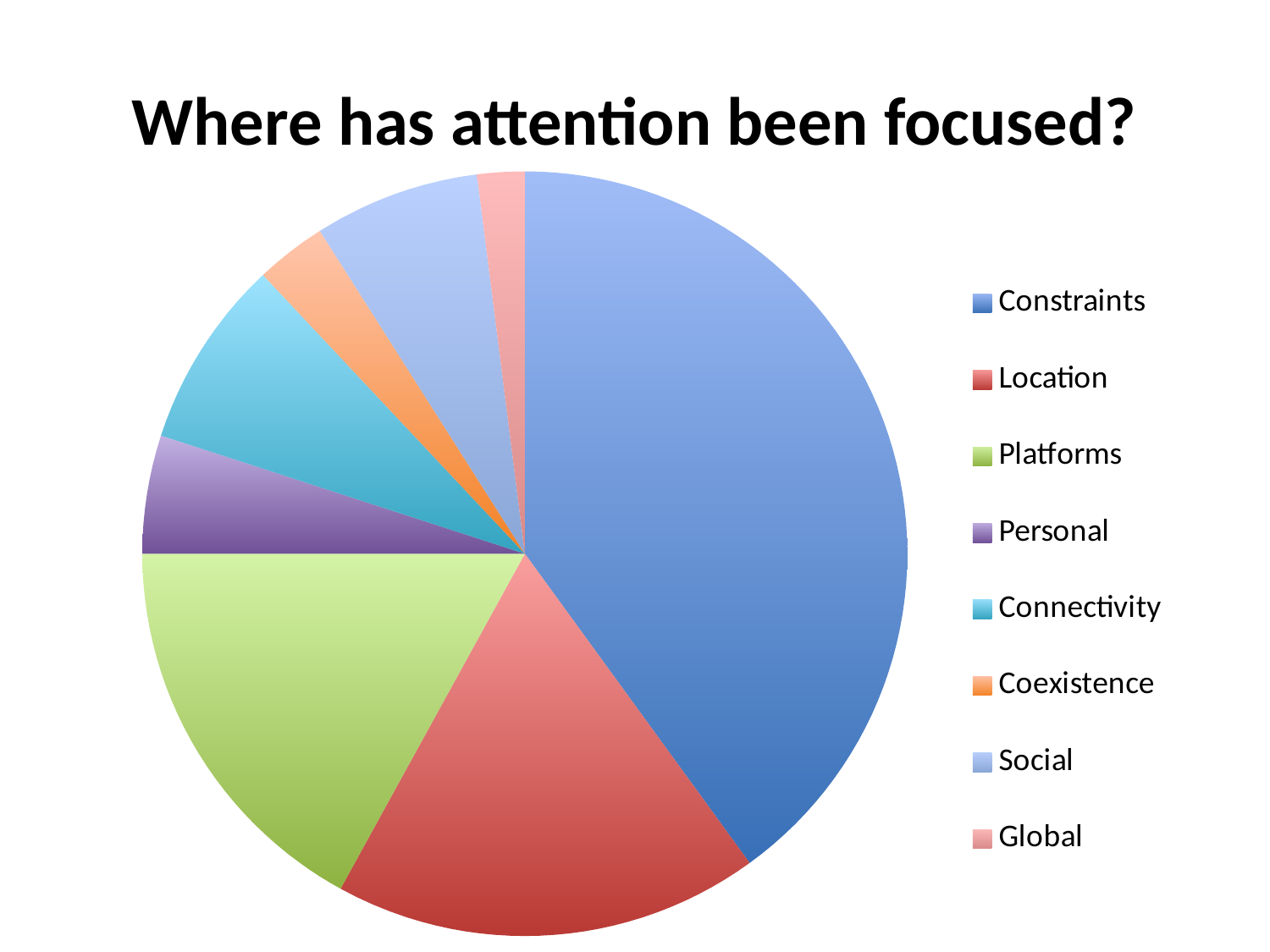
Which slice is larger, Social or Global? Social Which slice is larger, Constraints or Location? Constraints Which slice is larger, Connectivity or Coexistence? Connectivity Which category has the smallest slice of the pie? Global What is the title of the chart? Where has attention been focused? Which category is shown in green in the legend? Platforms What kind of chart is shown on the slide? Pie chart How many entries does the legend list? 8 Which category has the largest slice of the pie? Constraints How many slices does the pie chart have? 8